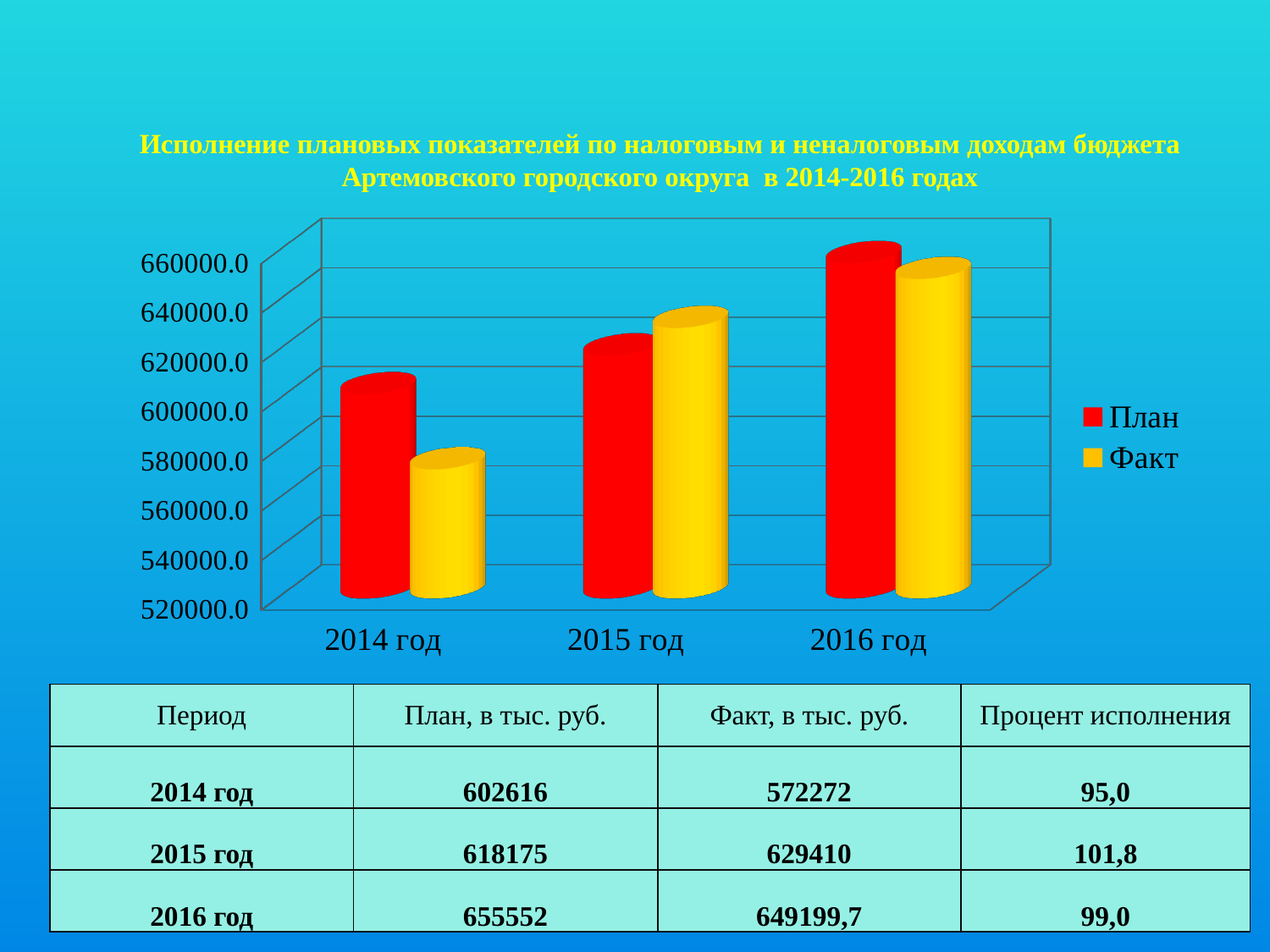
Do the План values rise or fall from 2014 год to 2016 год? rise Is the Факт value for 2014 год greater or less than 580000.0? less In which year is the Факт value lowest? 2014 год What is the Факт value for 2016 год? 649199,7 What is the difference between План and Факт for 2014 год? 30344 What kind of chart is shown on the slide? bar chart In which year is the План value highest? 2016 год For 2015 год, which is larger: План or Факт? Факт How many series does the chart legend list? 2 How many year categories are shown on the x axis of the chart? 3 Is the План value for 2016 год greater or less than 640000.0? greater What is the План value for 2014 год? 602616